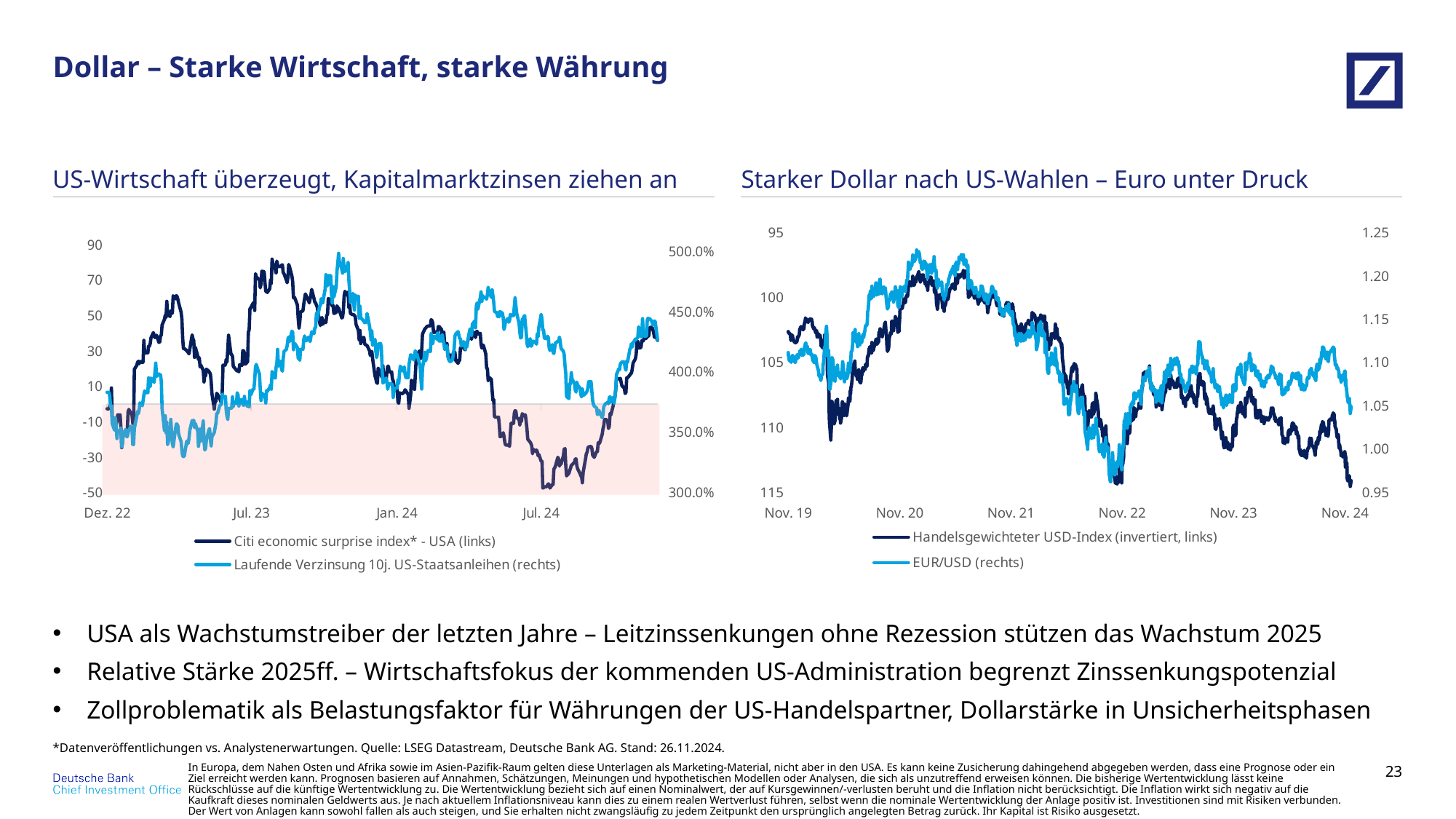
What kind of chart is the left chart titled 'US-Wirtschaft überzeugt, Kapitalmarktzinsen ziehen an'? Line chart How many x-axis labels are shown on the right chart? 6 In the right chart, is the EUR/USD value at Nov. 20 greater or less than 1.10? greater In the right chart, is the EUR/USD value at Nov. 24 greater or less than 1.10? less In the left chart, which series is plotted on the right axis according to the legend? Laufende Verzinsung 10j. US-Staatsanleihen (rechts) What kind of chart is the right chart titled 'Starker Dollar nach US-Wahlen – Euro unter Druck'? Line chart In the left chart, is the value of the Citi economic surprise index at Jul. 24 greater or less than 0? less How many series does the legend of the left chart list? 2 How many series does the legend of the right chart list? 2 In the right chart, which series is plotted on the left axis according to the legend? Handelsgewichteter USD-Index (invertiert, links)